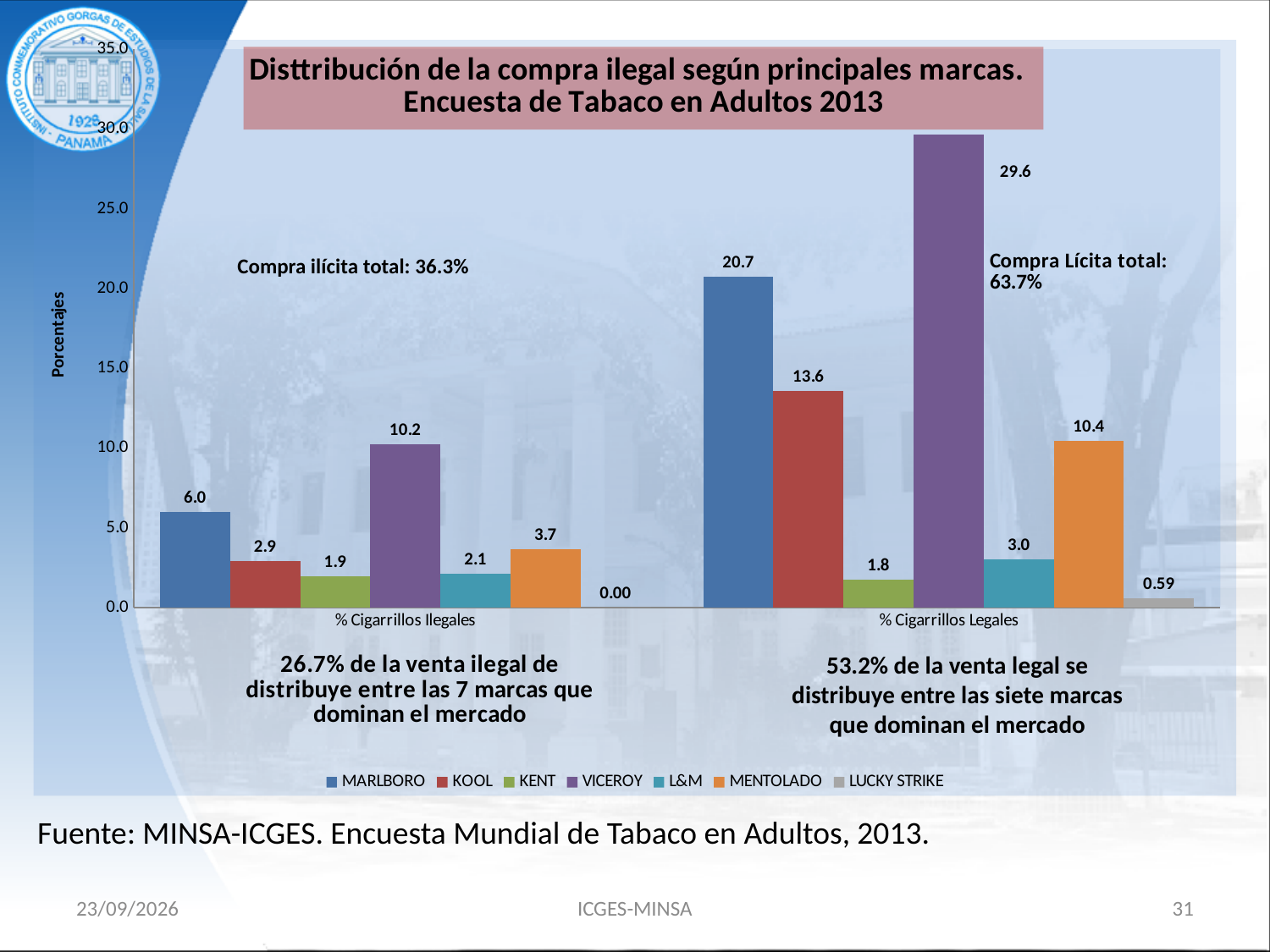
What kind of chart is shown on the slide? Bar chart How many series does the legend list? 7 Which is larger: KOOL in % Cigarrillos Legales or MENTOLADO in % Cigarrillos Legales? KOOL in % Cigarrillos Legales What is the value for MENTOLADO in the % Cigarrillos Ilegales group? 3.7 What is the difference between the MARLBORO values for % Cigarrillos Legales and % Cigarrillos Ilegales? 14.7 What is the value for MARLBORO in the % Cigarrillos Ilegales group? 6.0 How many categories are shown on the x axis? 2 Which brand has the highest value in the % Cigarrillos Ilegales group? VICEROY What is the value for LUCKY STRIKE in the % Cigarrillos Legales group? 0.59 Which brand has the lowest value in the % Cigarrillos Legales group? LUCKY STRIKE What is the total illicit purchase percentage (Compra ilícita total) stated on the chart? 36.3% What is the value for VICEROY in the % Cigarrillos Legales group? 29.6